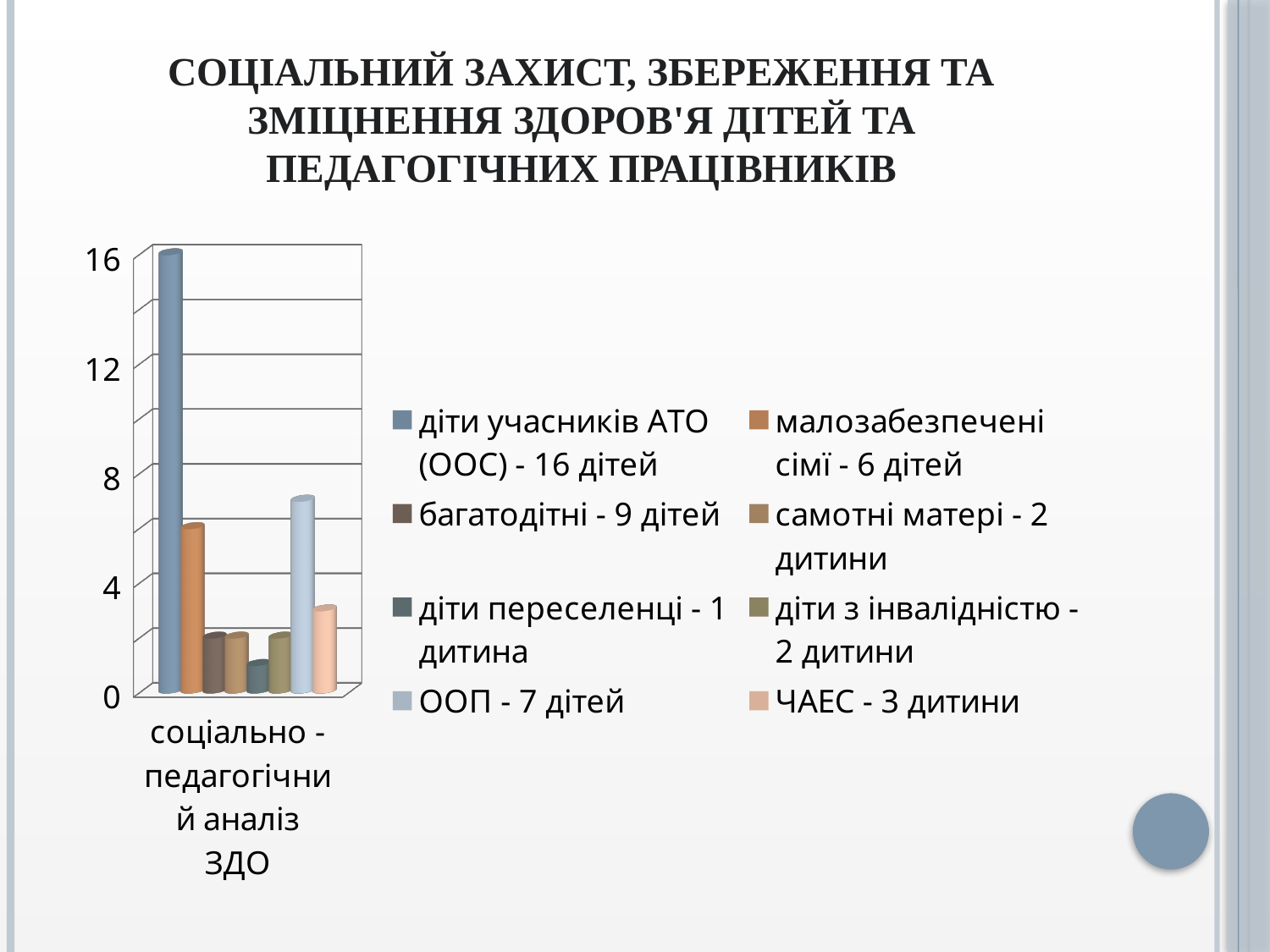
What value does the legend give for ЧАЕС? 3 дитини Which series has the tallest bar in the chart? діти учасників АТО (ООС) How many series does the legend list? 8 What value does the legend give for діти учасників АТО (ООС)? 16 дітей What value does the legend give for ООП? 7 дітей Which is larger: the value for ООП or the value for малозабезпечені сімї? ООП Is the value for діти учасників АТО (ООС) greater or less than 12? greater What kind of chart is shown on the slide? bar chart Which series has the shortest bar in the chart? діти переселенці What value does the legend give for малозабезпечені сімї? 6 дітей What is the difference between the number of діти учасників АТО (ООС) and the number of ООП children? 9 What is the category label shown on the x axis of the chart? соціально - педагогічний аналіз ЗДО